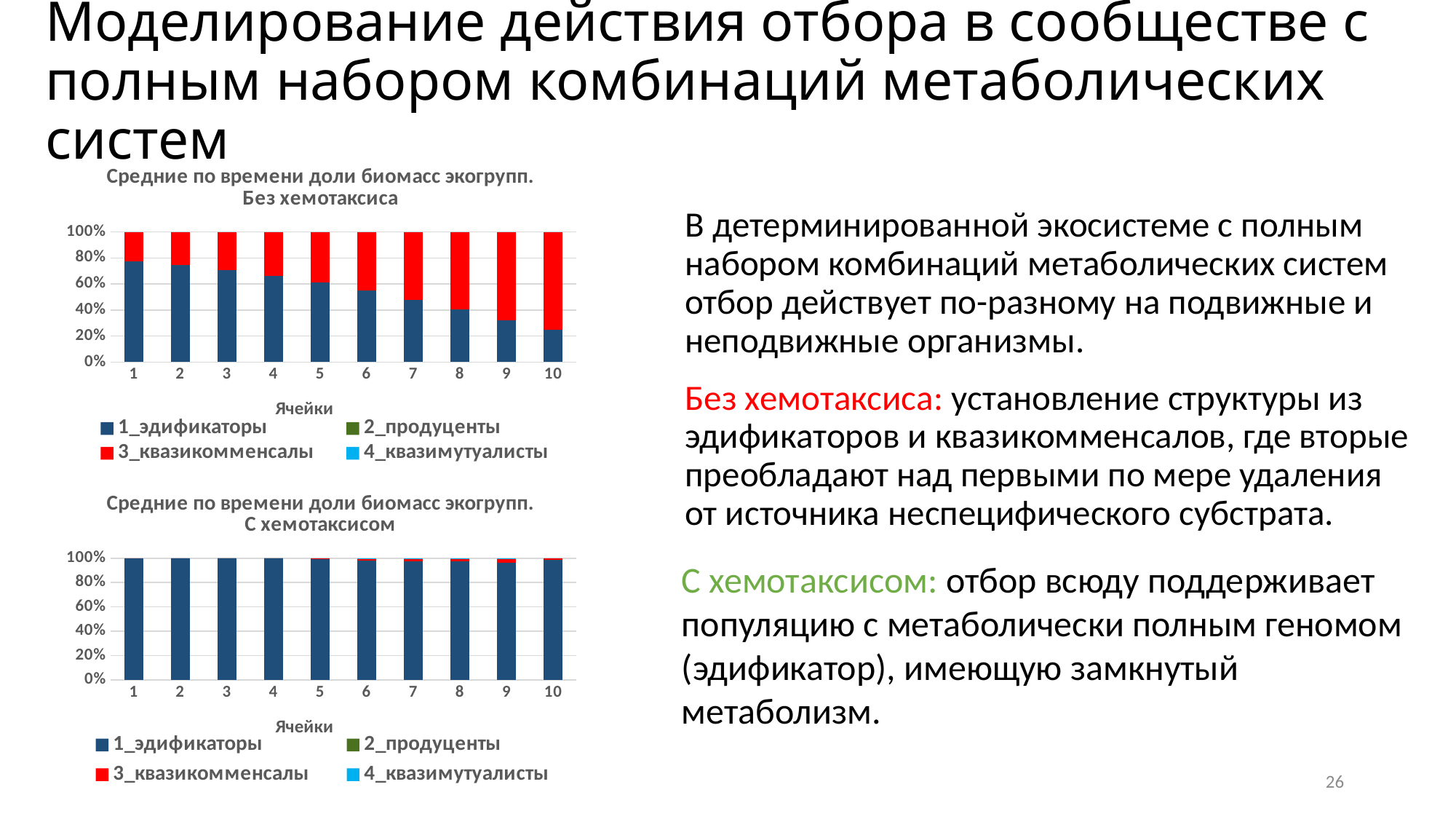
In the top chart (Без хемотаксиса), which cell has the highest share of 3_квазикомменсалы? 10 In the top chart (Без хемотаксиса), which cell has the lowest share of 1_эдификаторы? 10 What kind of chart is the top chart titled "Средние по времени доли биомасс экогрупп. Без хемотаксиса"? Stacked bar chart How many series does the legend of the bottom chart (С хемотаксисом) list? 4 In the top chart (Без хемотаксиса), is the share of 1_эдификаторы for cell 1 greater or less than 60%? greater In the bottom chart (С хемотаксисом), what is the total of the stacked bar for cell 5? 100% In the top chart (Без хемотаксиса), does the share of 1_эдификаторы rise or fall from cell 1 to cell 10? fall In the bottom chart (С хемотаксисом), is the share of 1_эдификаторы for cell 1 greater or less than 80%? greater In the top chart (Без хемотаксиса), is the share of 1_эдификаторы for cell 10 greater or less than 40%? less In the top chart (Без хемотаксиса), which has the larger share of 1_эдификаторы: cell 3 or cell 8? cell 3 What is the x-axis title of the top chart (Без хемотаксиса)? Ячейки In the top chart (Без хемотаксиса), how many cells (Ячейки) are shown on the x axis? 10